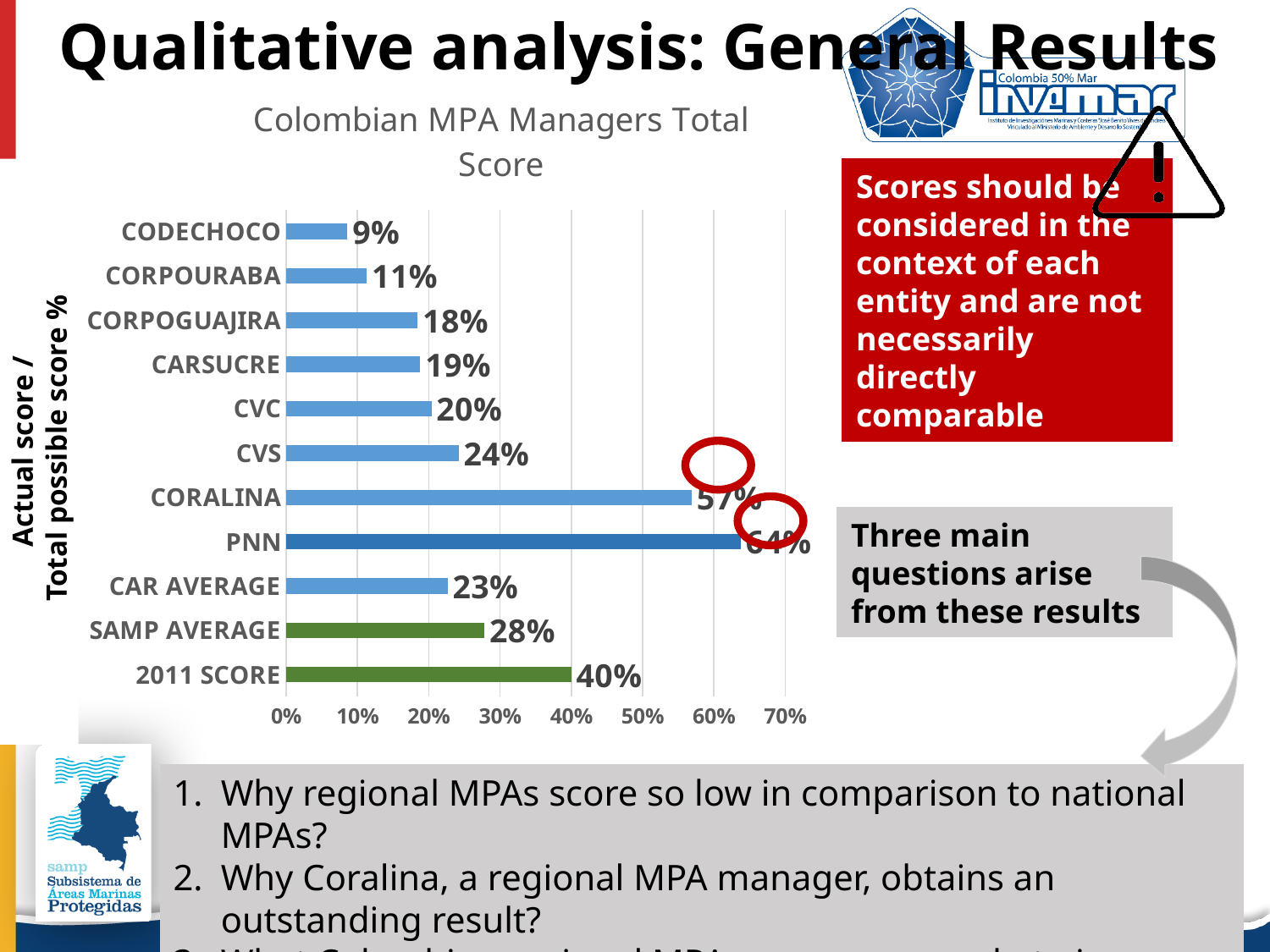
What is the value for 2011 SCORE? 40% Is the value for PNN greater or less than 60%? greater Is the value for CORALINA greater or less than 50%? greater Which is larger, the value for CARSUCRE or the value for CVC? CVC How many categories are shown in the chart? 11 What type of chart is shown? Bar chart Which category has the lowest score? CODECHOCO What is the value for CVS? 24% What is the value for SAMP AVERAGE? 28% What is the difference between the 2011 SCORE and the SAMP AVERAGE? 12% What is the value for CODECHOCO? 9% Which category has the highest score? PNN